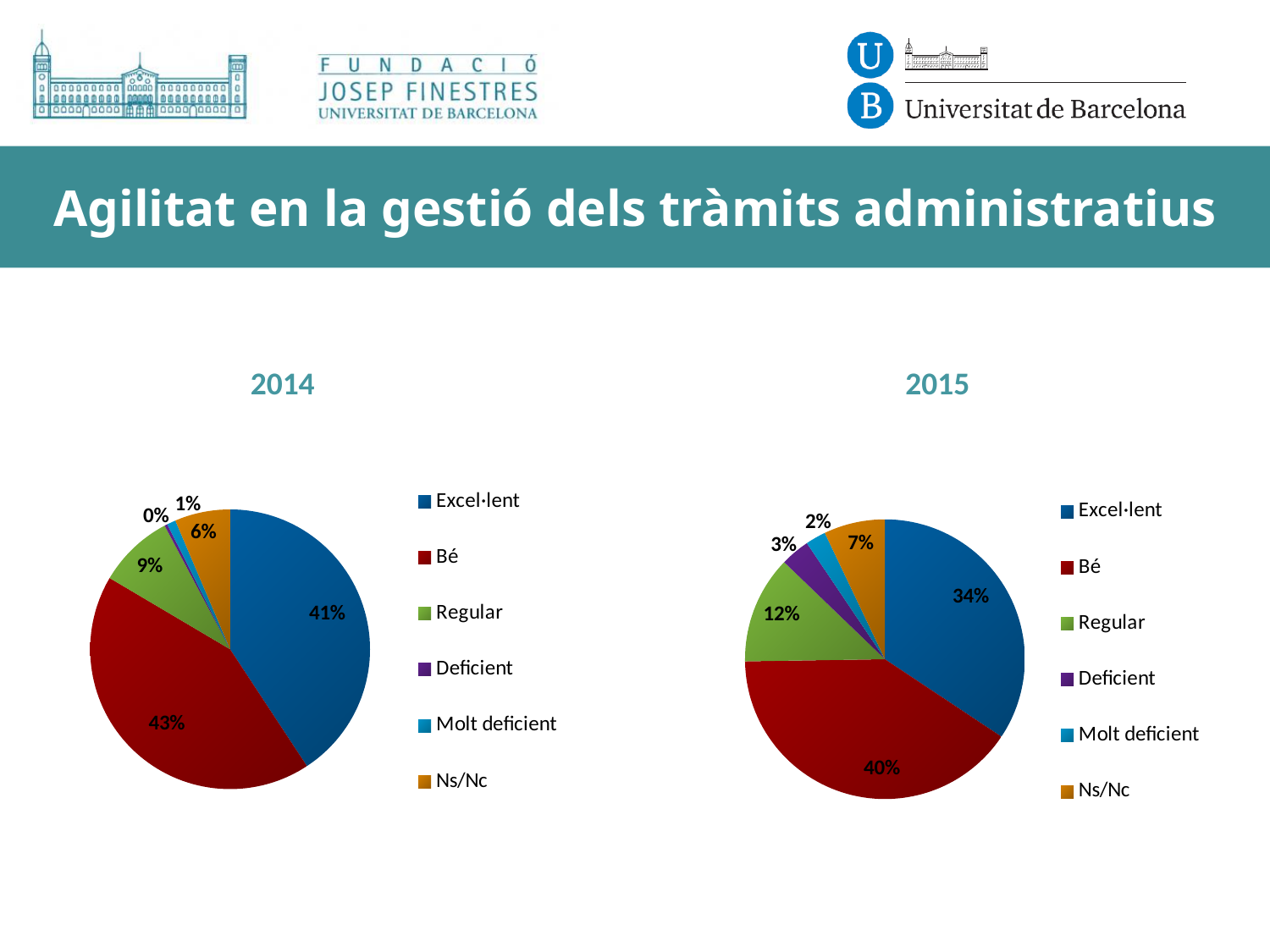
How many categories does the legend of the 2015 pie chart list? 6 What colour represents Regular in both pie charts? Green In the 2014 pie chart, what percentage is shown for Bé? 43% In the 2015 pie chart, what percentage is shown for Excel·lent? 34% In the 2014 pie chart, what percentage is shown for Ns/Nc? 6% In the 2014 pie chart, what percentage is shown for Deficient? 0% In the 2015 pie chart, what is the difference between the Bé and Excel·lent shares? 6% What kind of chart is used for the 2014 data? Pie chart Which is larger in the 2014 pie chart: Regular or Ns/Nc? Regular In the 2015 pie chart, which category has the smallest share? Molt deficient In the 2014 pie chart, which category has the largest share? Bé In the 2015 pie chart, what percentage is shown for Regular? 12%